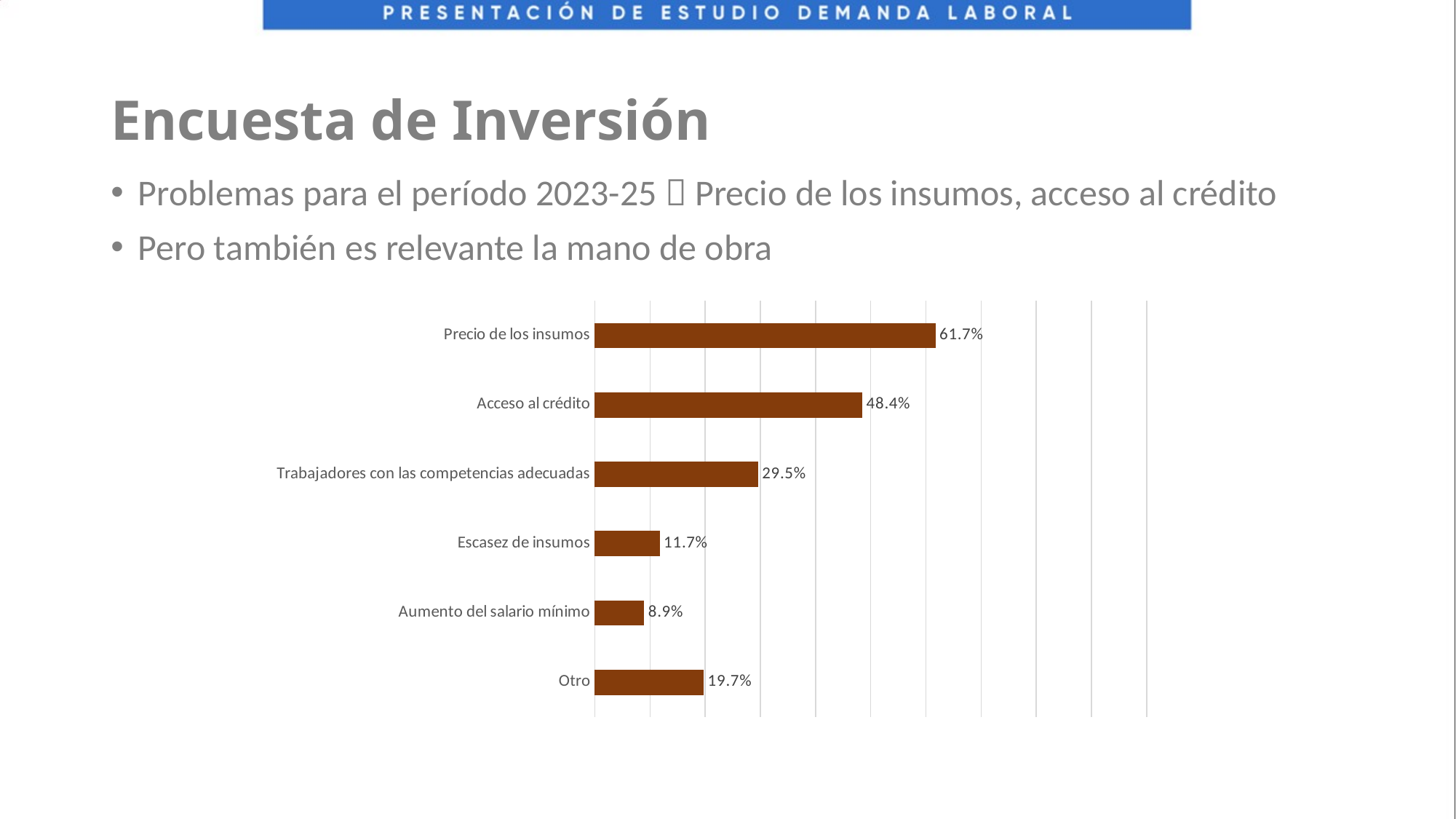
How many categories are shown in the chart? 6 What is the value for Precio de los insumos? 61.7% Which category has the highest value? Precio de los insumos What is the difference between the values for Precio de los insumos and Acceso al crédito? 13.3% Which is larger, the value for Otro or the value for Escasez de insumos? Otro What is the value for Escasez de insumos? 11.7% What is the value for Acceso al crédito? 48.4% What is the value for Trabajadores con las competencias adecuadas? 29.5% What is the value for Otro? 19.7% What is the value for Aumento del salario mínimo? 8.9% Which category has the lowest value? Aumento del salario mínimo What kind of chart is shown on the slide? Bar chart